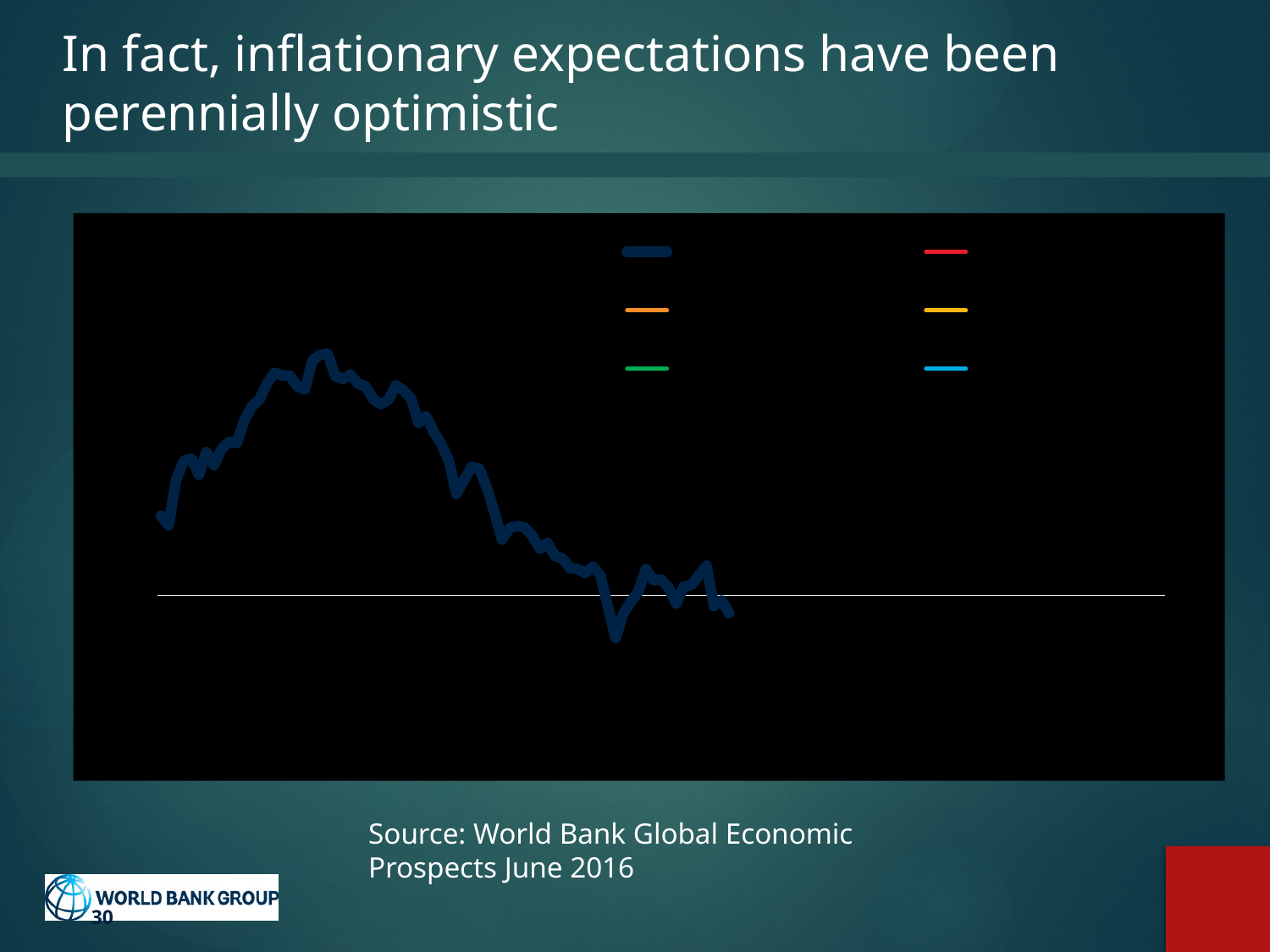
How many lines are actually plotted on the chart? 1 How many series entries does the chart's legend show? 6 What is the background colour of the chart area? black Does the plotted line rise or fall over its right-hand half? fall Does the plotted line end higher or lower than where it starts on the left? lower What colour is the line plotted on the chart? dark blue What kind of chart is shown on the slide? line chart